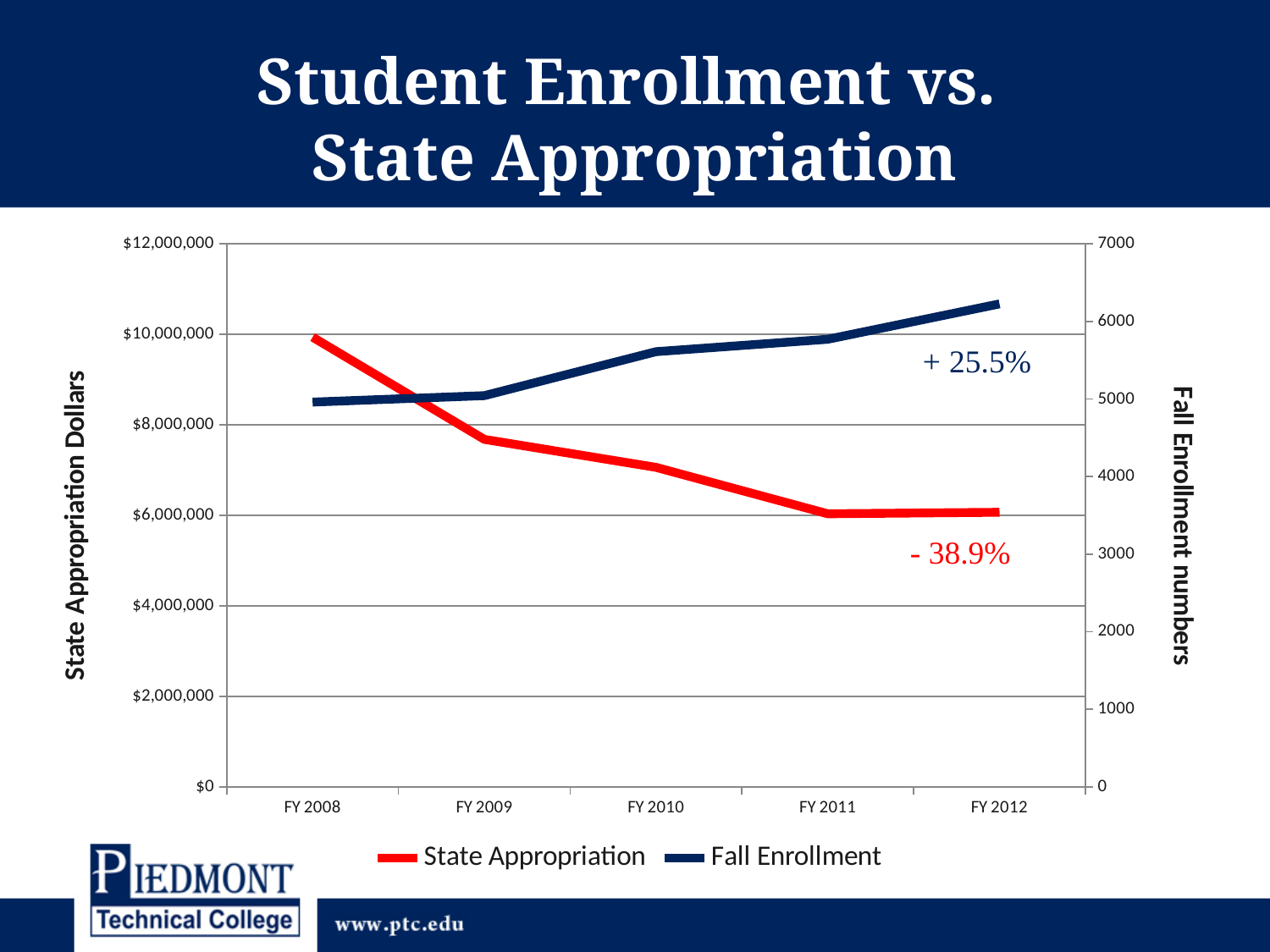
Is the Fall Enrollment value for FY 2012 greater or less than 6000? greater How many fiscal years are plotted along the x axis? 5 In which fiscal year is State Appropriation highest? FY 2008 What kind of chart is shown on the slide? line chart Is the State Appropriation value for FY 2010 greater or less than $8,000,000? less Is the State Appropriation value for FY 2008 greater or less than $8,000,000? greater In which fiscal year is Fall Enrollment highest? FY 2012 How many series does the legend list? 2 What percentage change is annotated next to the Fall Enrollment line? + 25.5% What is the title of the chart on the slide? Student Enrollment vs. State Appropriation Does the State Appropriation line rise or fall from FY 2008 to FY 2012? fall Does the Fall Enrollment line rise or fall from FY 2008 to FY 2012? rise